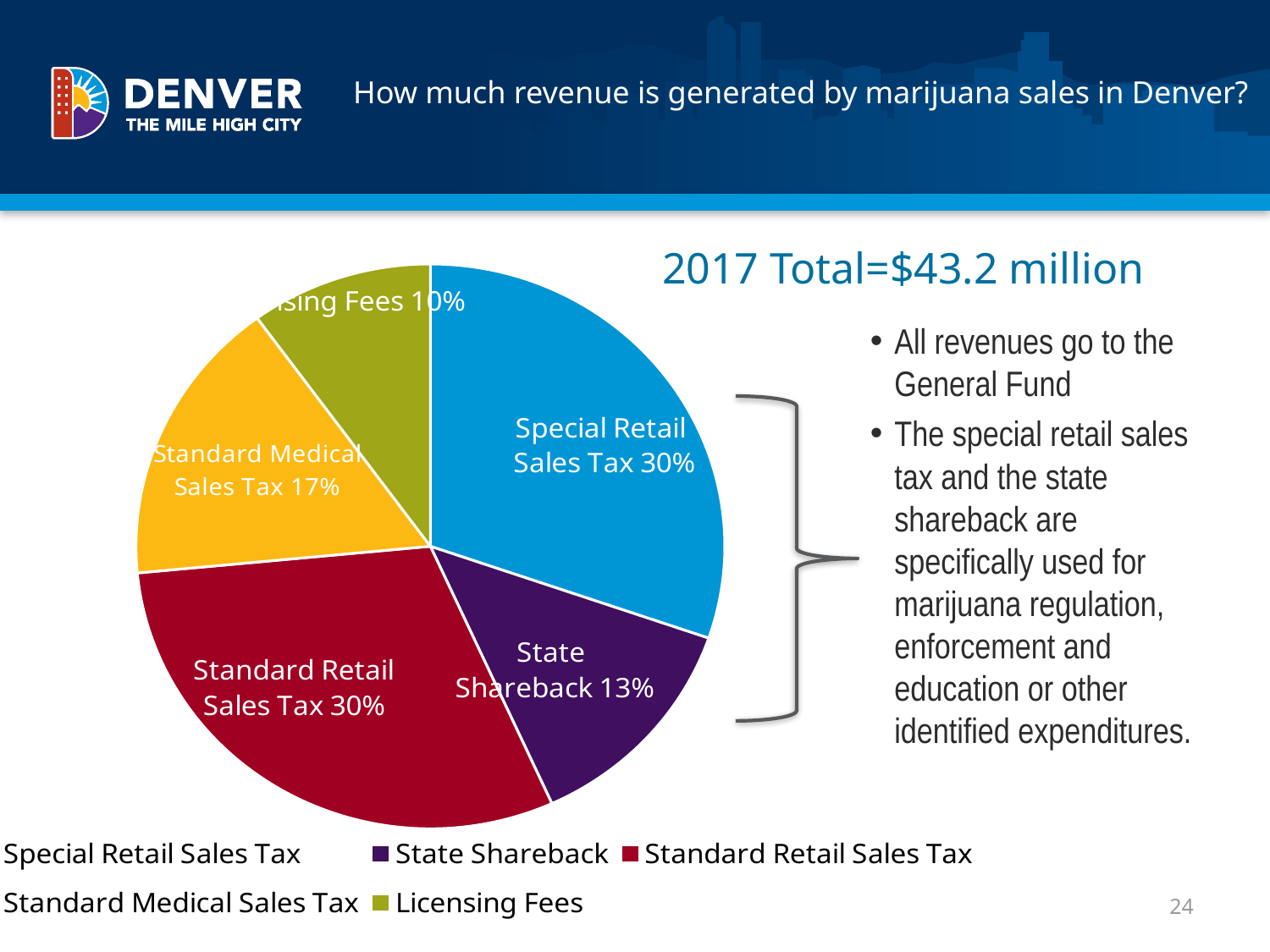
What is the difference in percentage points between Standard Medical Sales Tax and State Shareback? 4 What share of the pie does Licensing Fees represent? 10% How many slices does the pie chart have? 5 What share of the pie does Standard Retail Sales Tax represent? 30% How many entries does the legend list? 5 What total amount is stated above the pie chart for 2017? $43.2 million Which category has the smallest slice of the pie? Licensing Fees What share of the pie does Special Retail Sales Tax represent? 30% What kind of chart is shown on the slide? Pie chart Which is larger, the State Shareback slice or the Standard Medical Sales Tax slice? Standard Medical Sales Tax